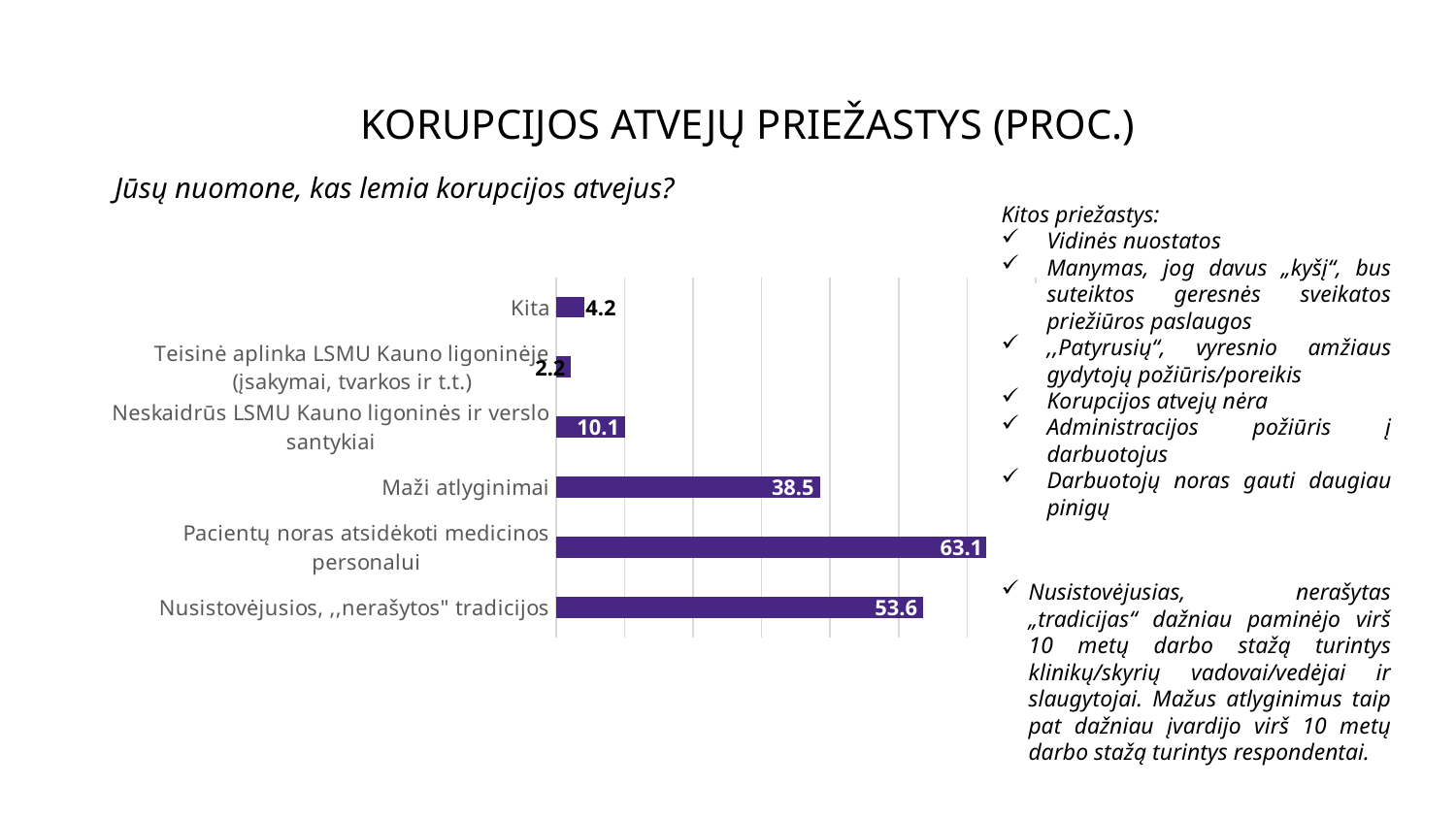
What is the value for "Neskaidrūs LSMU Kauno ligoninės ir verslo santykiai"? 10.1 What is the difference between the values for "Pacientų noras atsidėkoti medicinos personalui" and "Nusistovėjusios ,,nerašytos" tradicijos"? 9.5 What is the title of the slide containing the chart? KORUPCIJOS ATVEJŲ PRIEŽASTYS (PROC.) Which category has the highest value? Pacientų noras atsidėkoti medicinos personalui What is the value for "Kita"? 4.2 What is the value for "Maži atlyginimai"? 38.5 What is the value for "Pacientų noras atsidėkoti medicinos personalui"? 63.1 How many categories are shown in the chart? 6 Which category has the lowest value? Teisinė aplinka LSMU Kauno ligoninėje (įsakymai, tvarkos ir t.t.) What is the difference between the values for "Maži atlyginimai" and "Neskaidrūs LSMU Kauno ligoninės ir verslo santykiai"? 28.4 What kind of chart is shown on the slide? Bar chart Which is larger: the value for "Nusistovėjusios ,,nerašytos" tradicijos" or the value for "Maži atlyginimai"? Nusistovėjusios ,,nerašytos" tradicijos